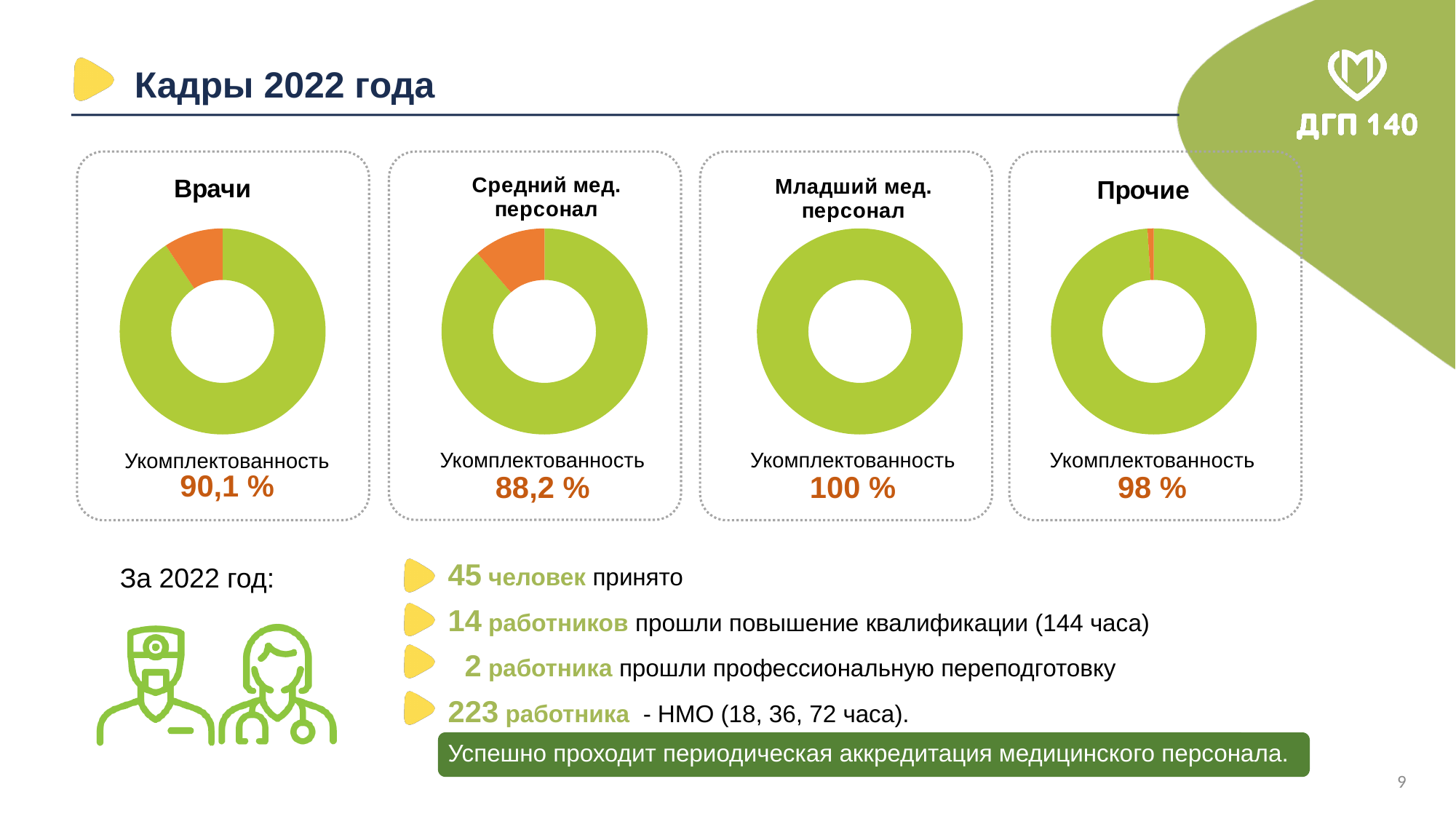
What colour represents the filled (staffed) portion in the donut charts? Green Which of the four staff categories has the lowest staffing level? Средний мед. персонал On the 'Прочие' chart, what is the staffing level shown? 98 % Which of the four staff categories has the highest staffing level? Младший мед. персонал On the 'Средний мед. персонал' chart, what is the staffing level shown? 88,2 % Which has a higher staffing level: 'Врачи' or 'Прочие'? Прочие How many donut charts are shown on the slide? 4 On the 'Врачи' chart, what is the staffing level (Укомплектованность) shown? 90,1 % On the 'Младший мед. персонал' chart, what is the staffing level shown? 100 % What is the difference between the staffing levels of 'Прочие' and 'Врачи'? 7,9 % What type of chart is used to show the staffing level for each staff category? Donut (pie) chart What is the difference between the staffing levels of 'Младший мед. персонал' and 'Средний мед. персонал'? 11,8 %